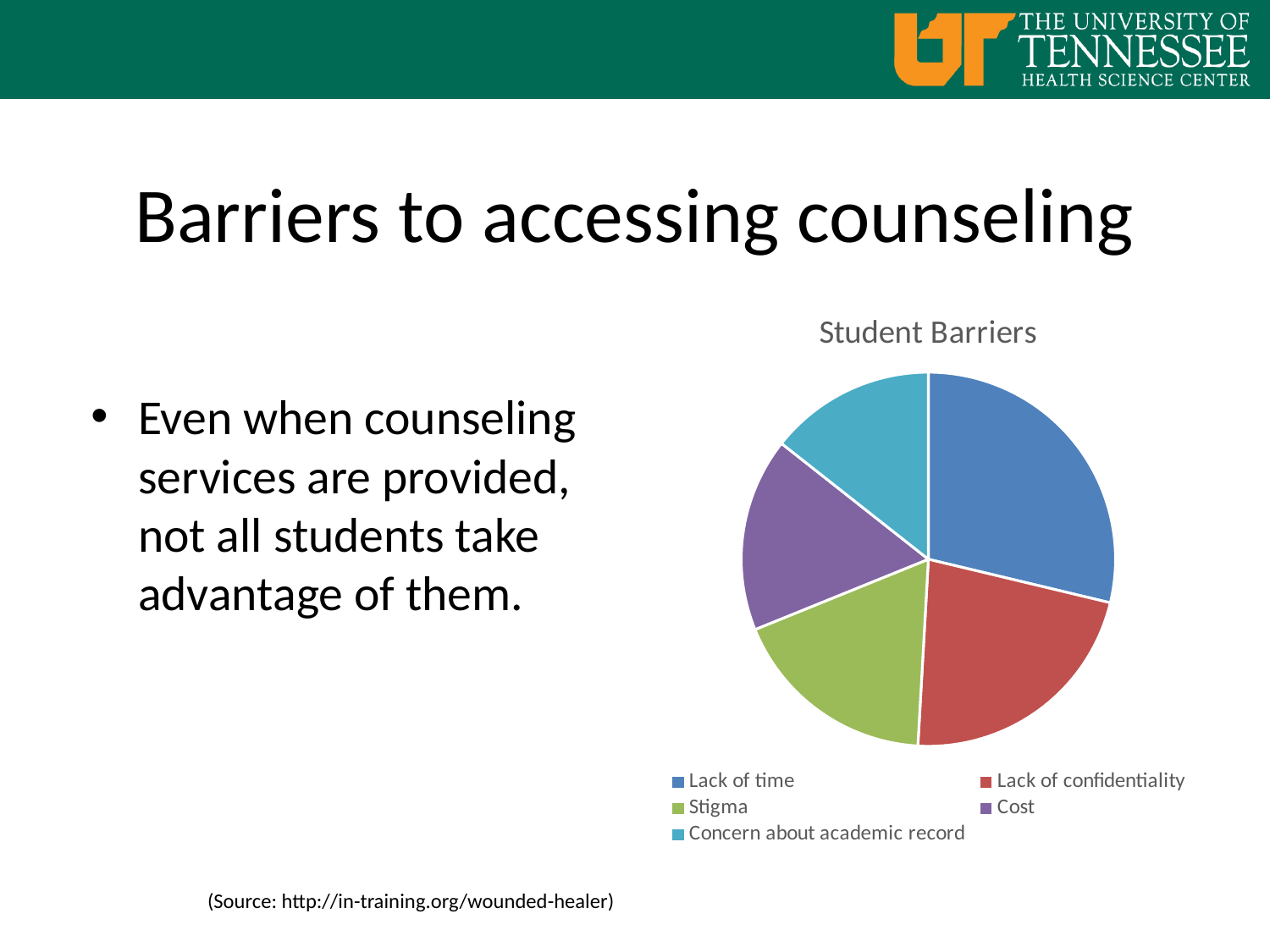
How many categories (slices) does the pie chart have? 5 How many entries does the chart legend list? 5 What kind of chart is shown on the slide? pie chart Which colour represents Stigma in the pie chart? green Which slice is larger, Lack of confidentiality or Concern about academic record? Lack of confidentiality What is the title of the chart? Student Barriers Which barrier has the largest slice of the pie? Lack of time Which slice is larger, Stigma or Concern about academic record? Stigma Which slice is larger, Lack of time or Cost? Lack of time